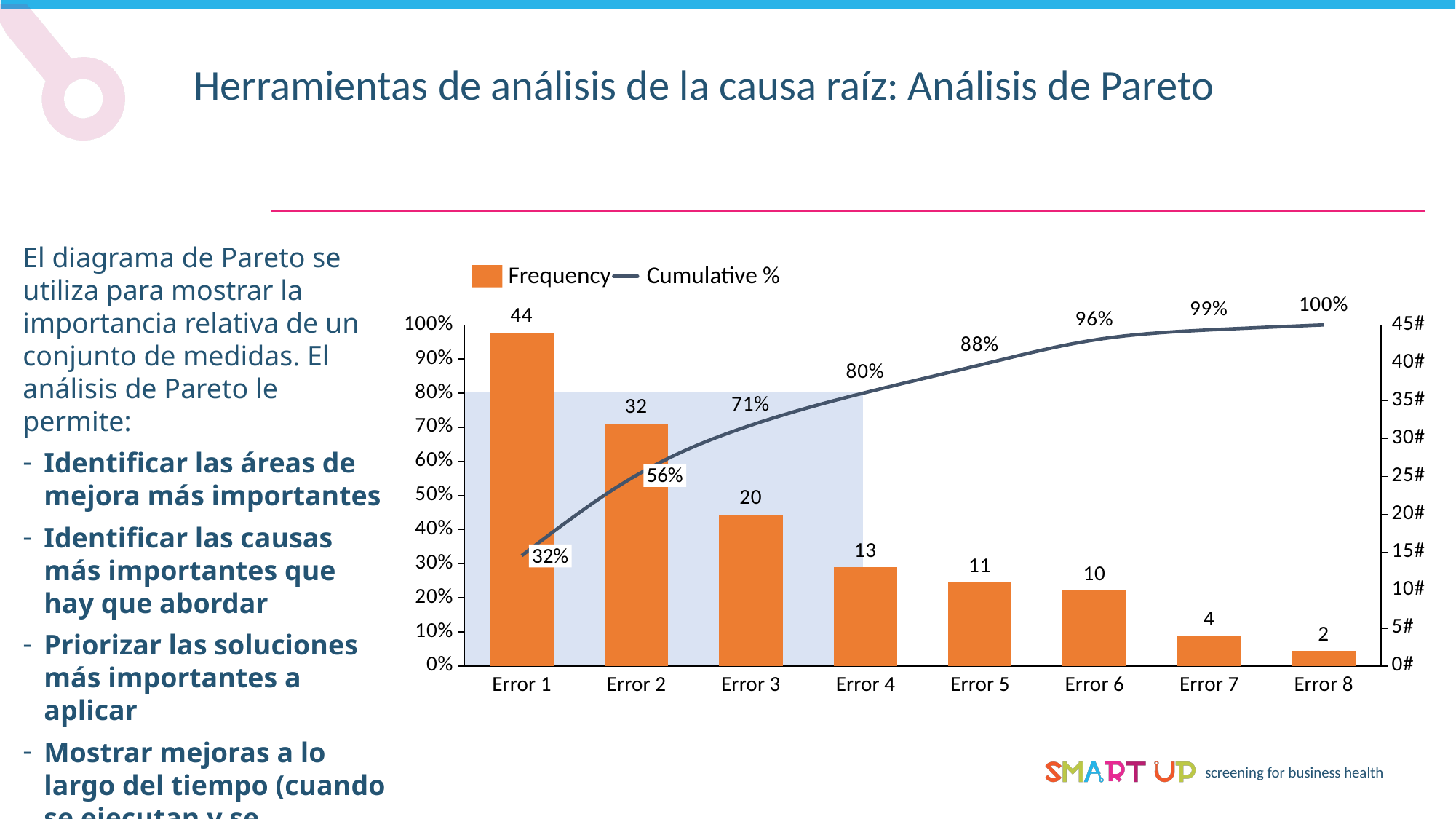
What are the two series named in the legend? Frequency and Cumulative % Which has a higher Frequency, Error 3 or Error 5? Error 3 What is the Frequency value for Error 1? 44 What is the Frequency value for Error 7? 4 How many categories are shown on the x axis? 8 What is the difference in Frequency between Error 1 and Error 2? 12 How many series does the legend list? 2 What is the Cumulative % value at Error 4? 80% What is the Cumulative % value at Error 2? 56% Which category has the lowest Frequency? Error 8 Does the Cumulative % line rise or fall from Error 1 to Error 8? rise Which category has the highest Frequency? Error 1